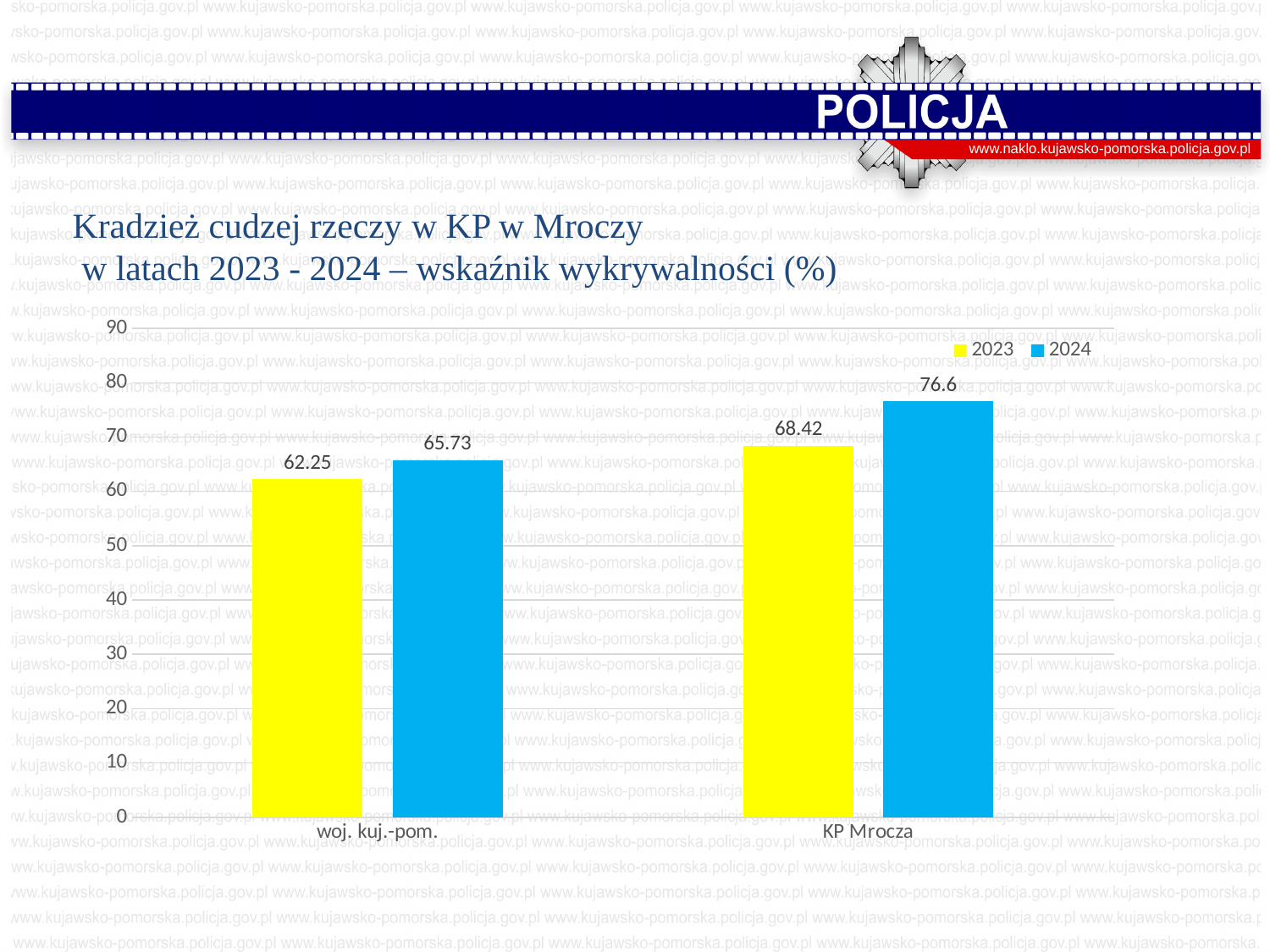
Which is larger: the 2023 value for KP Mrocza or the 2024 value for woj. kuj.-pom.? 2023 value for KP Mrocza What is the 2023 value for woj. kuj.-pom.? 62.25 Which category has the highest 2024 value? KP Mrocza Which category has the lowest 2023 value? woj. kuj.-pom. How many categories are shown on the x axis? 2 What is the difference between the 2024 and 2023 values for KP Mrocza? 8.18 How many series does the legend list? 2 What is the 2024 value for woj. kuj.-pom.? 65.73 What is the 2024 value for KP Mrocza? 76.6 What is the 2023 value for KP Mrocza? 68.42 What is the difference between the 2024 and 2023 values for woj. kuj.-pom.? 3.48 What kind of chart is shown on the slide? bar chart